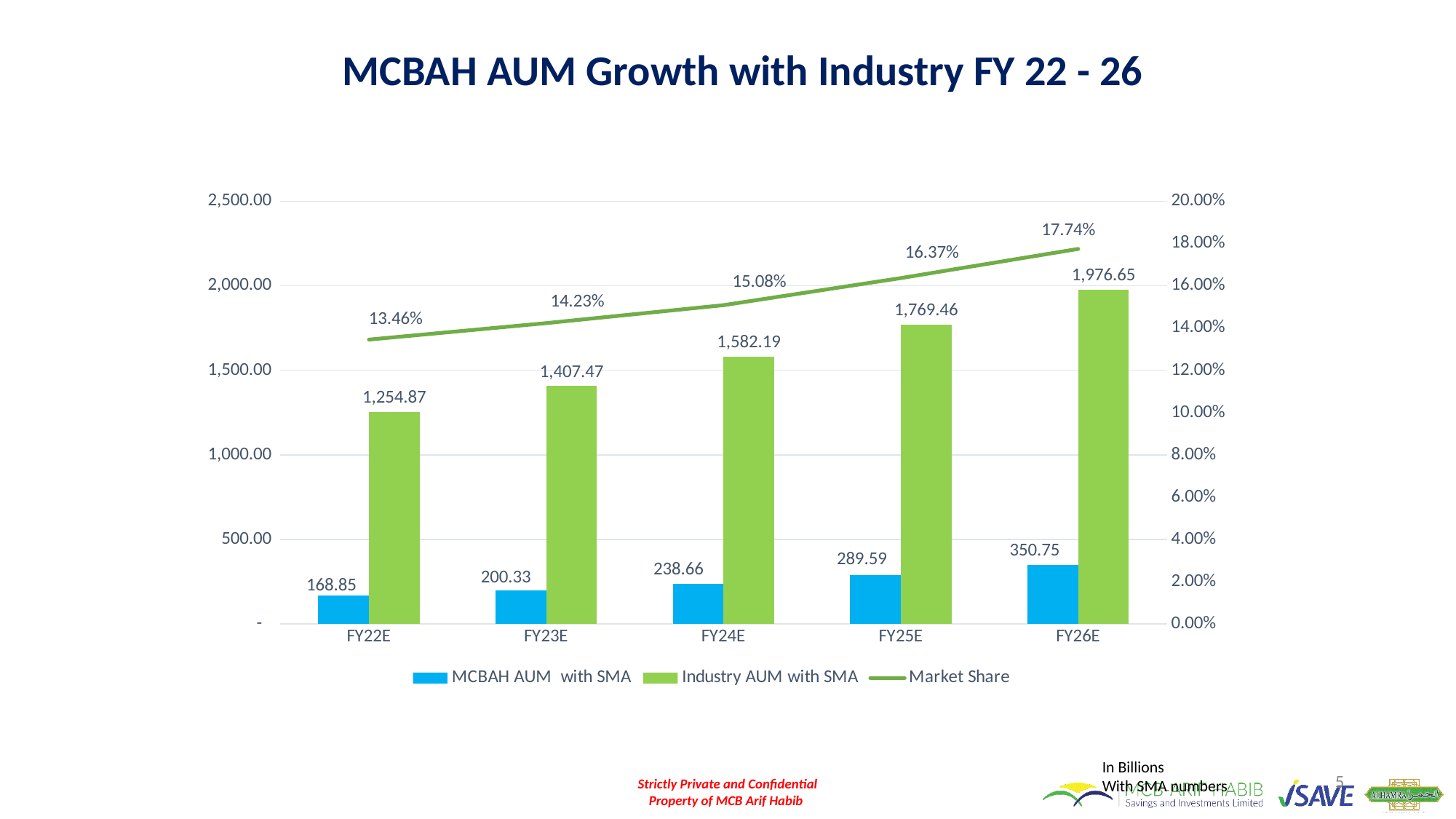
What is the Industry AUM with SMA value for FY22E? 1,254.87 What is the difference between the Industry AUM with SMA for FY26E and FY25E? 207.19 How many series does the legend list? 3 What kind of chart is used to show the AUM values? bar chart What is the Market Share for FY25E? 16.37% What is the title of the chart? MCBAH AUM Growth with Industry FY 22 - 26 Does the Market Share rise or fall from FY22E to FY26E? rise Is the MCBAH AUM with SMA for FY26E greater or less than 500.00? less Which fiscal year has the highest Industry AUM with SMA? FY26E What is the MCBAH AUM with SMA value for FY24E? 238.66 How many fiscal years are shown on the x axis? 5 Which fiscal year has the lowest MCBAH AUM with SMA? FY22E